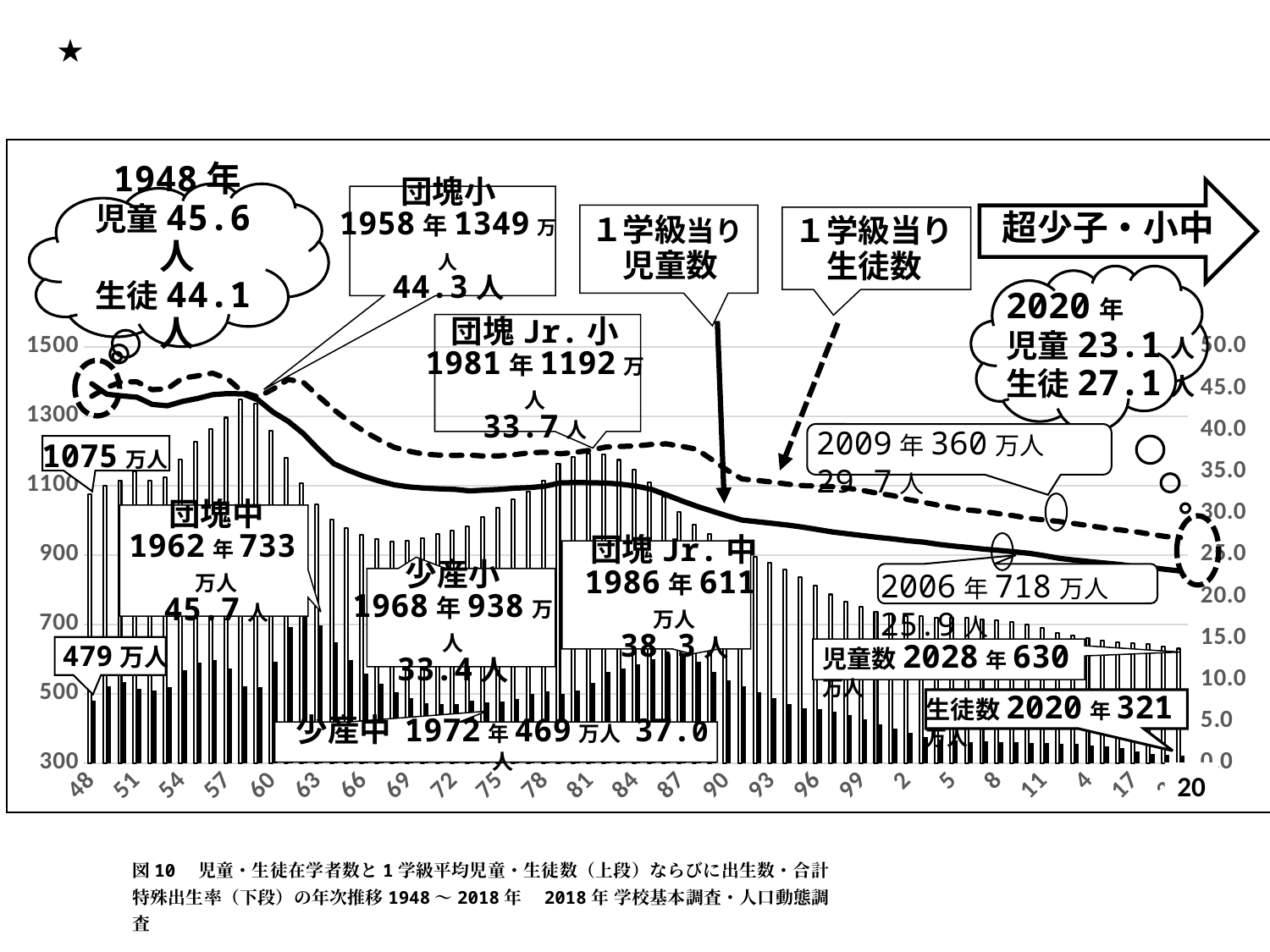
What is the highest value shown on the left vertical axis? 1500 What text is written inside the large arrow at the top right of the chart? 超少子・小中 According to the 2020年 annotation, what was the average number of 生徒 per class in 2020? 27.1人 What was the average number of 児童 per class in 1948 according to the annotation? 45.6人 What was the number of 生徒 (junior high students) in 1962 according to the 団塊中 annotation? 733万人 Which was larger: the 生徒 count in 1962 (団塊中) or in 1986 (団塊Jr.中)? 1962 (733万人) What kind of chart is this? Combination bar and line chart What is the difference between the 1958 児童 count (1349万人) and the 1981 児童 count (1192万人)? 157万人 Does the average number of 児童 per class (solid line) rise or fall overall from 1948 to 2020? fall According to the 団塊Jr.小 annotation, how many 児童 were there in 1981? 1192万人 What was the average number of 児童 per class in 1958 according to the 団塊小 annotation? 44.3人 According to the annotation, how many 児童 (elementary pupils) were there in 1958 (団塊小)? 1349万人